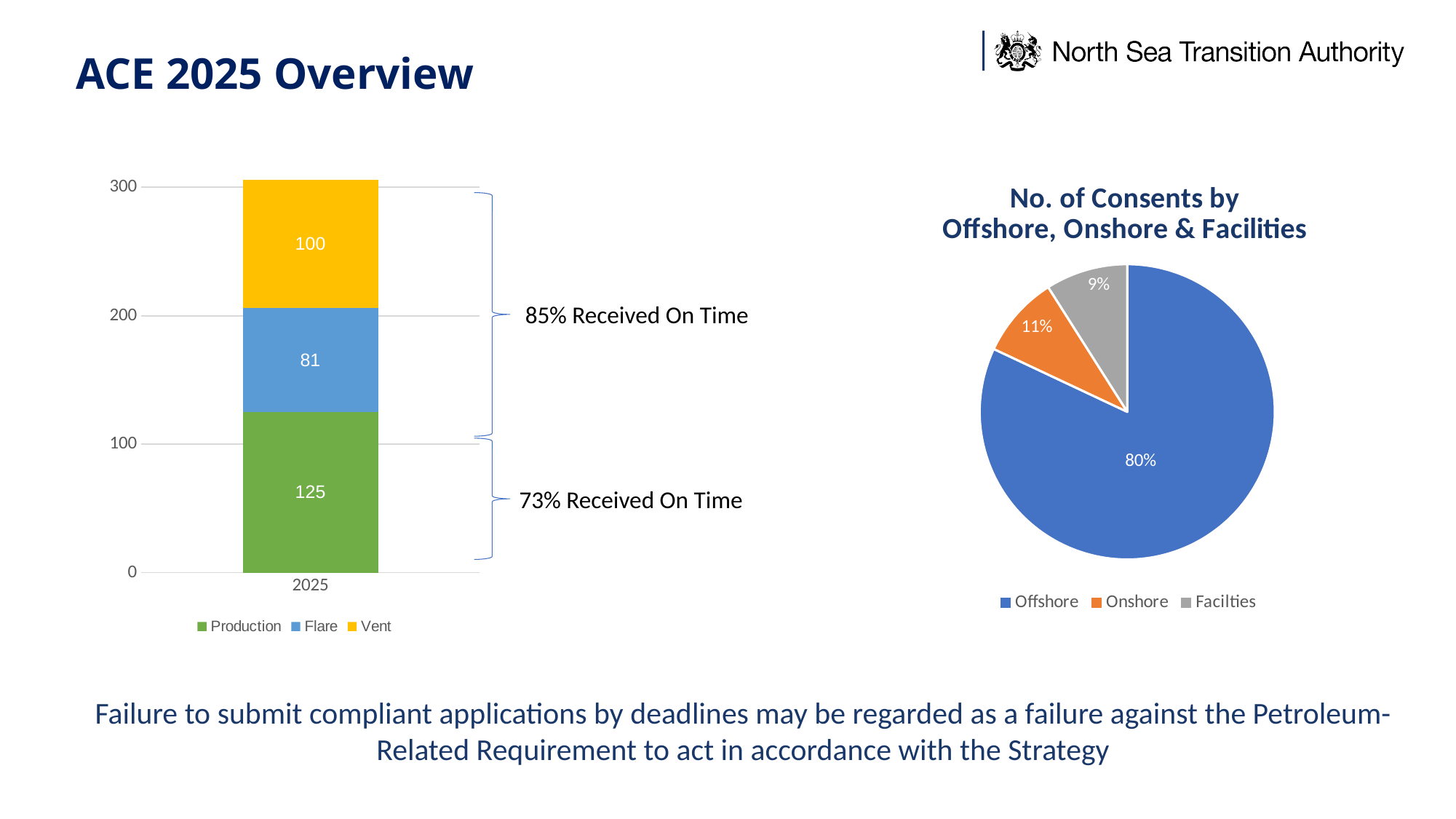
In the stacked bar chart on the left, how many series does the legend list? 3 In the stacked bar chart on the left, what is the value for Production in 2025? 125 In the stacked bar chart on the left, which series has the smallest value in 2025? Flare In the pie chart titled 'No. of Consents by Offshore, Onshore & Facilities', what share does Onshore have? 11% In the stacked bar chart on the left, what is the difference between the Production and Flare values? 44 In the stacked bar chart on the left, which series has the largest value in 2025? Production In the stacked bar chart on the left, what is the total of the 2025 bar across Production, Flare and Vent? 306 In the pie chart titled 'No. of Consents by Offshore, Onshore & Facilities', which category has the smallest share? Facilties In the stacked bar chart on the left, what is the value for Flare in 2025? 81 In the pie chart titled 'No. of Consents by Offshore, Onshore & Facilities', what share does Offshore have? 80% In the stacked bar chart on the left, what is the value for Vent in 2025? 100 What kind of chart is the one on the right of the slide? Pie chart